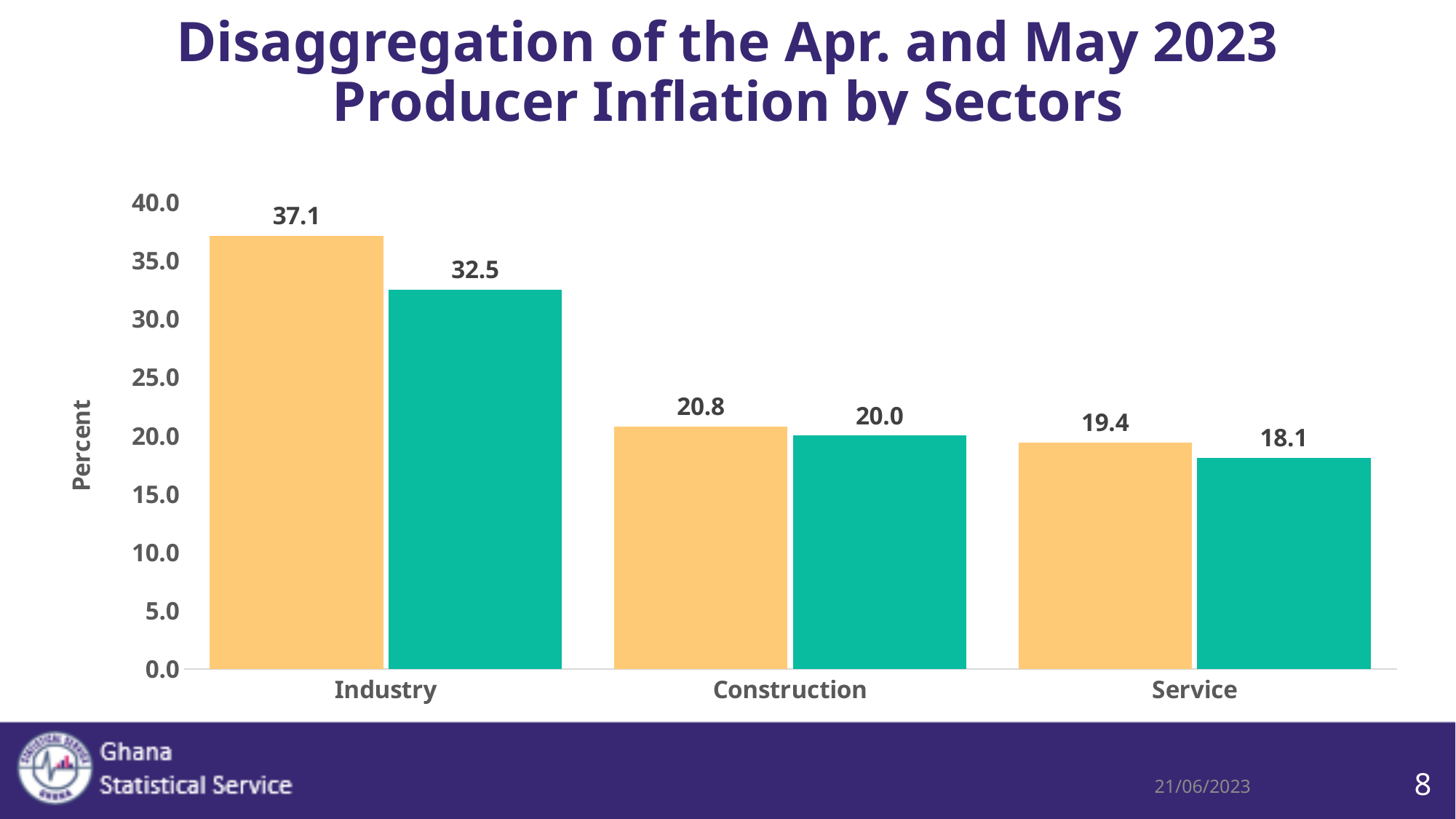
How many sectors are shown on the x axis of the chart? 3 What is the label on the vertical axis of the chart? Percent What is the value of the green bar for Industry? 32.5 What is the value of the green bar for Service? 18.1 Which sector has the lowest green bar? Service Which sector has the highest orange bar? Industry What is the difference between the orange and green bars for Industry? 4.6 Do the orange bar values rise or fall from Industry to Service along the x axis? fall What type of chart is shown on the slide? bar chart What is the value of the orange bar for Industry? 37.1 What is the value of the orange bar for Construction? 20.8 Which is larger for Construction, the orange bar or the green bar? the orange bar